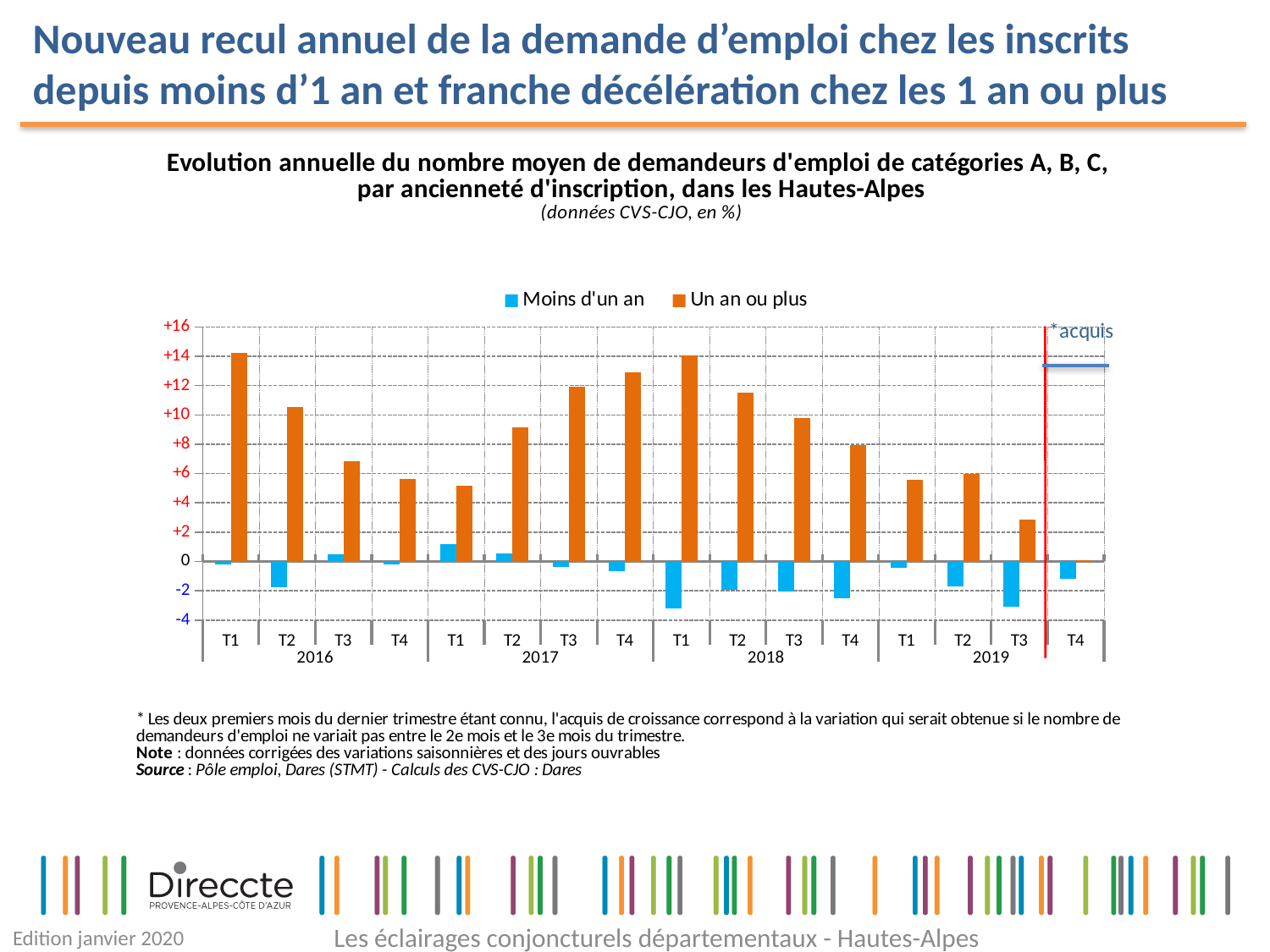
Which quarter has the lowest value for the 'Un an ou plus' series? T4 2019 Is the value for 'Un an ou plus' in T1 2016 greater or less than +12? greater Which quarter has the highest value for the 'Moins d'un an' series? T1 2017 How many quarters (bars per series) are plotted along the x axis? 16 Is the value for 'Moins d'un an' in T1 2018 greater or less than -2? less Which is larger for 'Un an ou plus': T2 2016 or T3 2016? T2 2016 Is the value for 'Un an ou plus' in T3 2019 greater or less than +4? less Which colour represents the 'Un an ou plus' series? Orange Do the 'Un an ou plus' values rise or fall from T1 to T4 of 2016? fall How many series does the legend list? 2 What kind of chart is shown on the slide? Bar chart Which is larger for 'Un an ou plus': T4 2017 or T4 2018? T4 2017